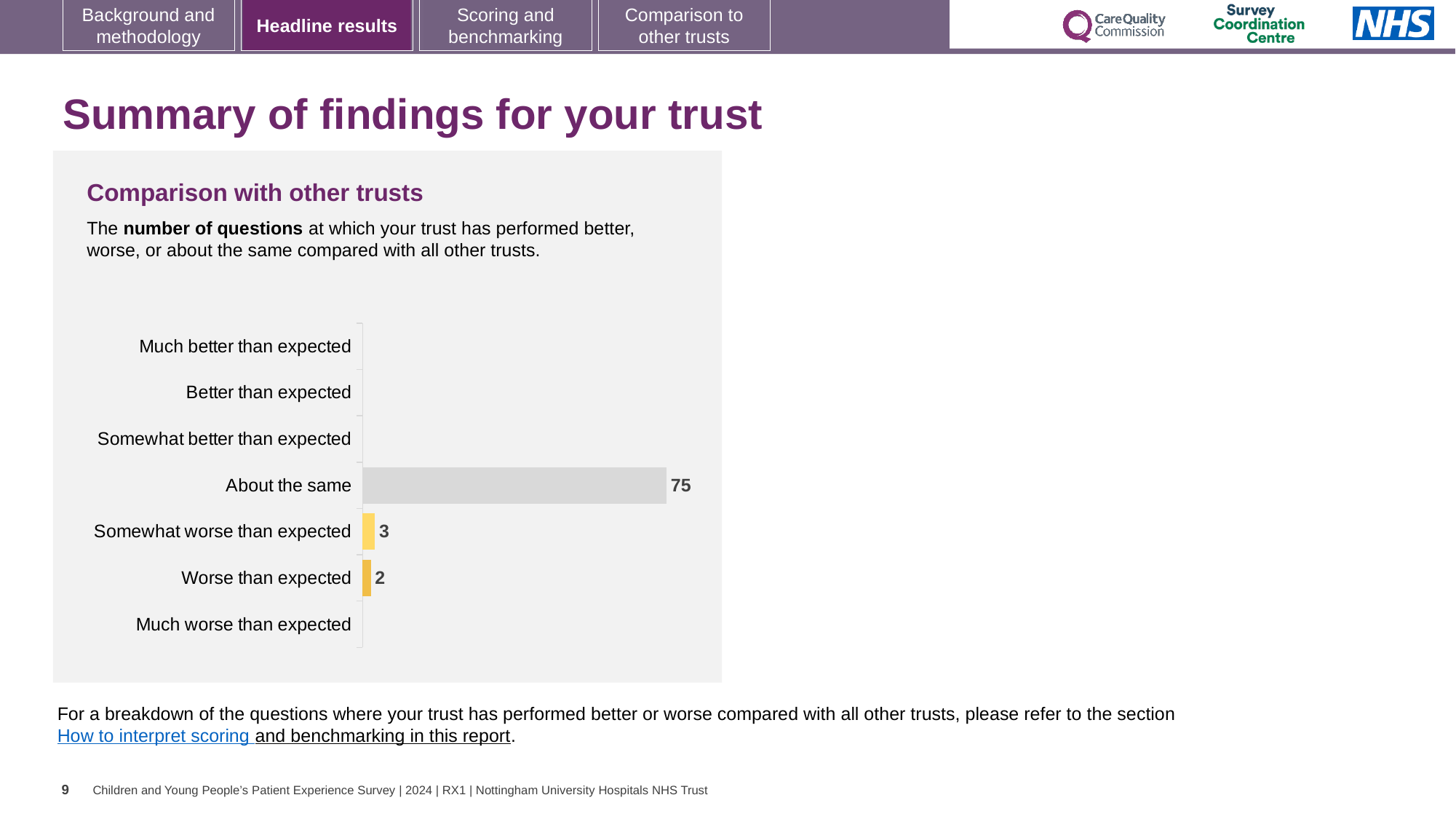
What is the difference between the values for 'About the same' and 'Worse than expected'? 73 Which is larger, the value for 'Somewhat worse than expected' or the value for 'Worse than expected'? Somewhat worse than expected What is the value for 'About the same'? 75 What is the difference between the values for 'About the same' and 'Somewhat worse than expected'? 72 What type of chart is shown on the slide? Bar chart How many categories are listed on the chart's axis? 7 What is the difference between the values for 'Somewhat worse than expected' and 'Worse than expected'? 1 What is the value for 'Somewhat worse than expected'? 3 Which category has the highest value? About the same What is the value for 'Worse than expected'? 2 What is the title of the chart? Comparison with other trusts What colour is the bar for 'About the same'? Grey